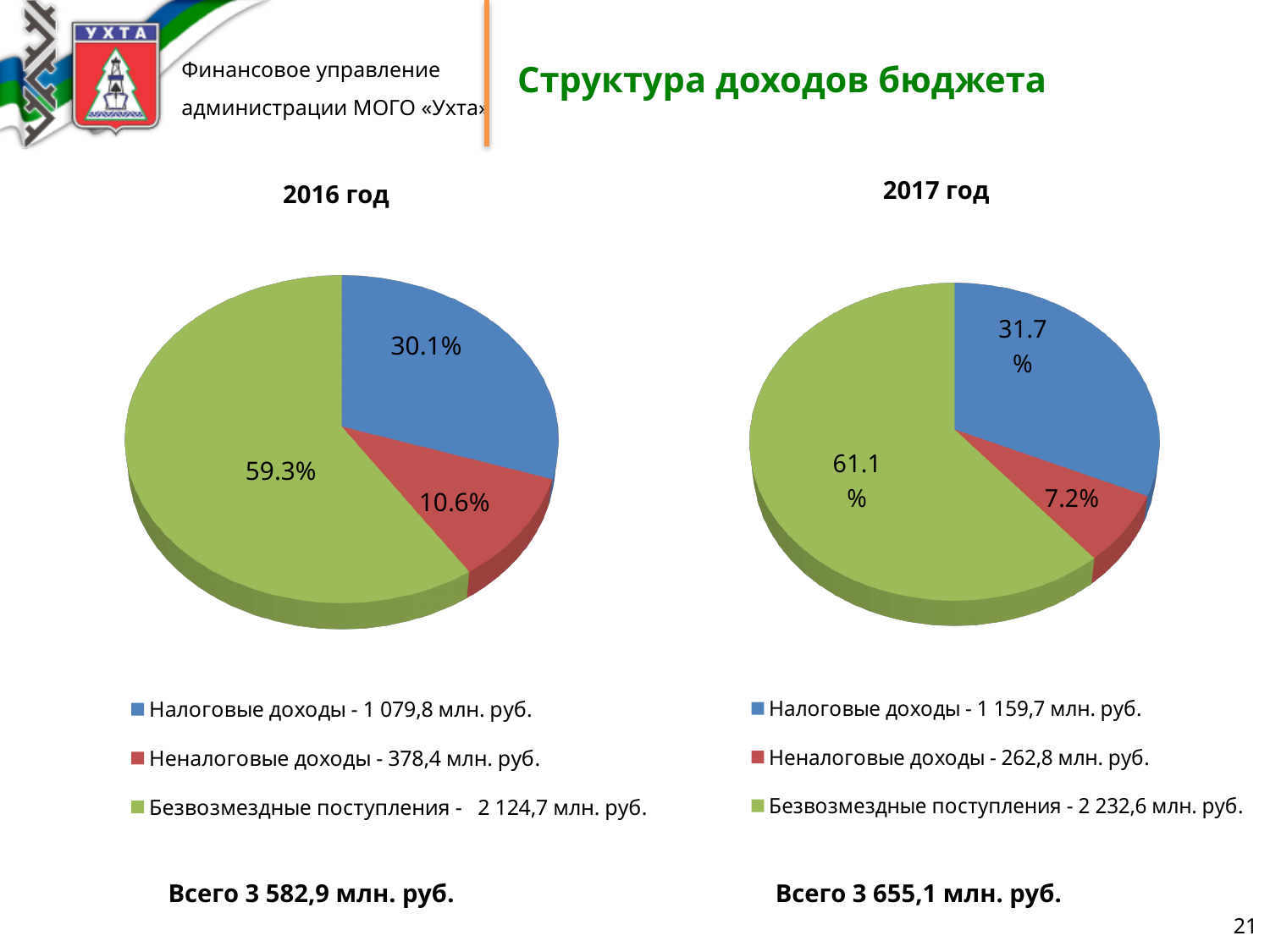
In the 2016 год chart, what share of the pie is Налоговые доходы? 30.1% In the 2017 год chart, what share of the pie is Неналоговые доходы? 7.2% How many slices does the 2017 год pie chart have? 3 Which is larger: the Неналоговые доходы share in the 2016 год chart or in the 2017 год chart? 2016 год In the 2016 год chart, what share of the pie is Безвозмездные поступления? 59.3% In the 2017 год chart, which category has the largest slice? Безвозмездные поступления What type of chart is used for the 2016 год chart? pie chart In the 2016 год chart, which category has the smallest slice? Неналоговые доходы In the 2017 год chart, what value does the legend give for Налоговые доходы? 1 159,7 млн. руб. What is the difference between the Безвозмездные поступления share in the 2017 год chart and in the 2016 год chart? 1.8%